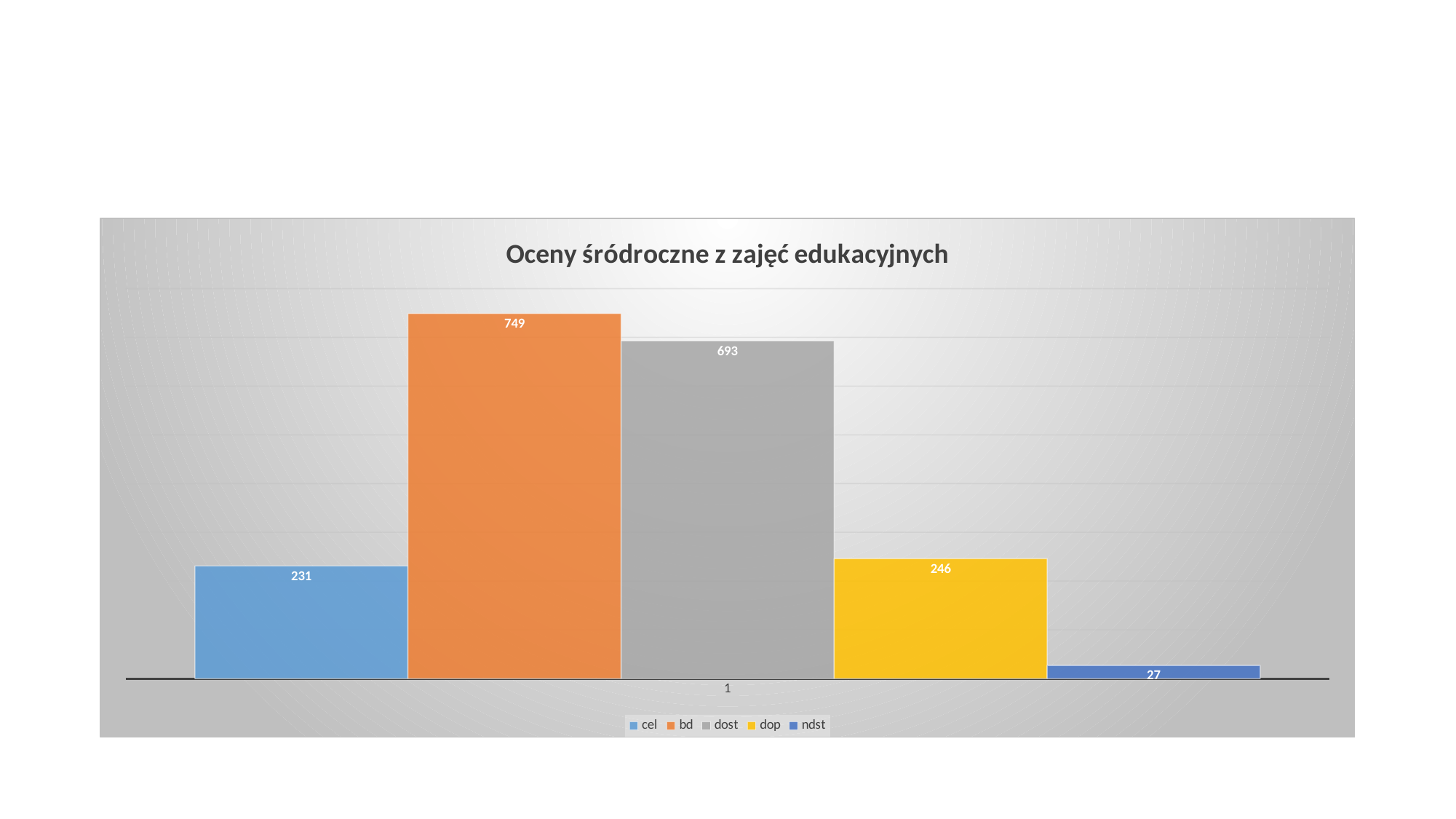
What is the value for ndst? 27 Which is larger, the value for cel or the value for dop? dop What is the value for dost? 693 Which series has the lowest value? ndst What is the difference between the values for bd and dost? 56 What is the difference between the values for dop and cel? 15 What is the value for dop? 246 How many series does the legend list? 5 What is the value for bd? 749 What is the value for cel? 231 What kind of chart is shown on the slide? bar chart Which series has the highest value? bd